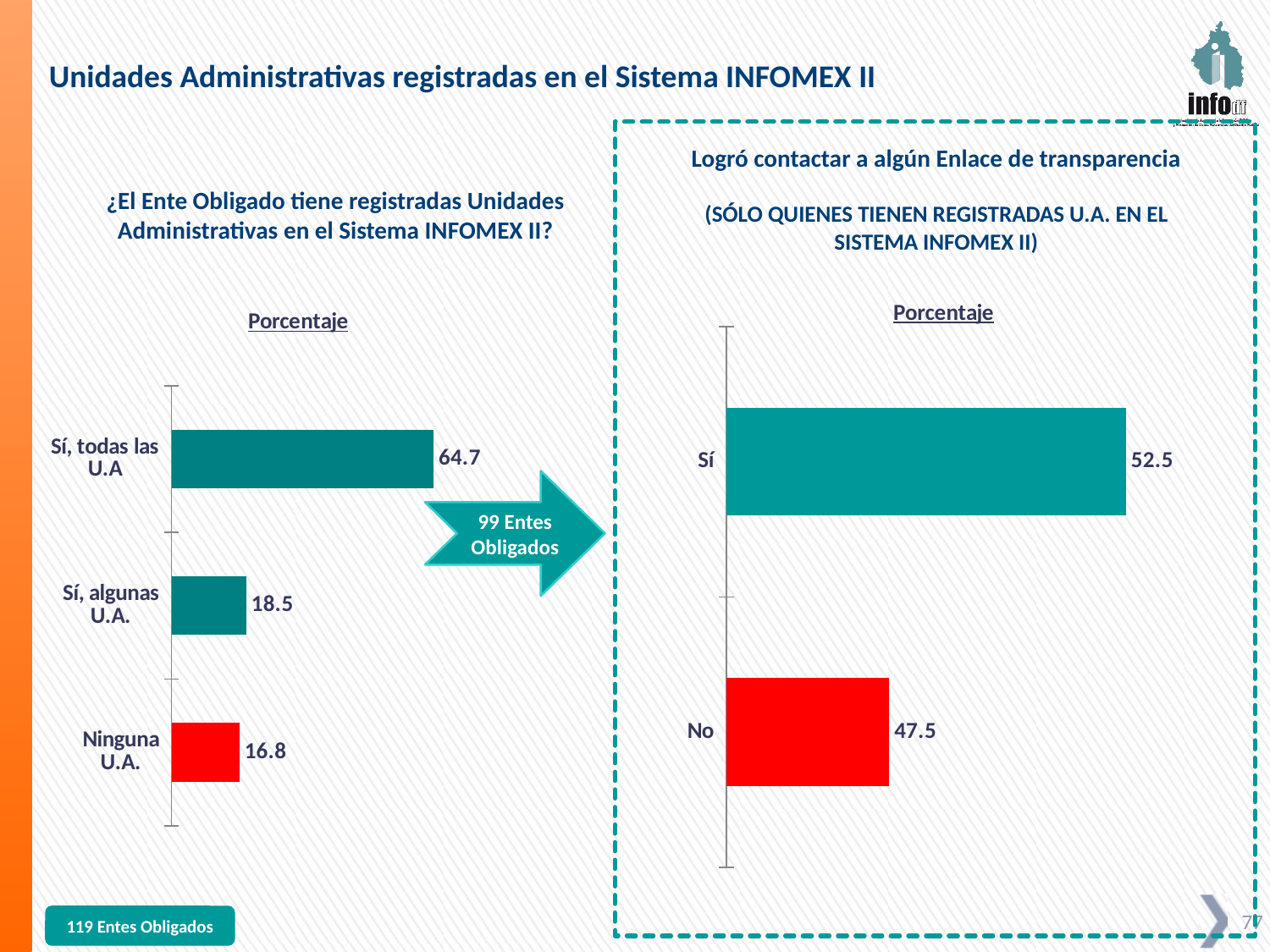
In the left chart, what colour is the bar for 'Ninguna U.A.'? Red In the right chart, which is larger, 'Sí' or 'No'? Sí In the right chart, what is the value for 'No'? 47.5 In the right chart, what is the difference between 'Sí' and 'No'? 5 In the left chart, which category has the lowest value? Ninguna U.A. In the left chart (¿El Ente Obligado tiene registradas Unidades Administrativas en el Sistema INFOMEX II?), what is the value for 'Sí, todas las U.A'? 64.7 In the left chart, what is the difference between 'Sí, todas las U.A' and 'Sí, algunas U.A.'? 46.2 In the left chart, how many categories are shown? 3 In the left chart, what is the value for 'Ninguna U.A.'? 16.8 What kind of chart is the right chart? Bar chart In the left chart, which category has the highest value? Sí, todas las U.A In the right chart (Logró contactar a algún Enlace de transparencia), what is the value for 'Sí'? 52.5